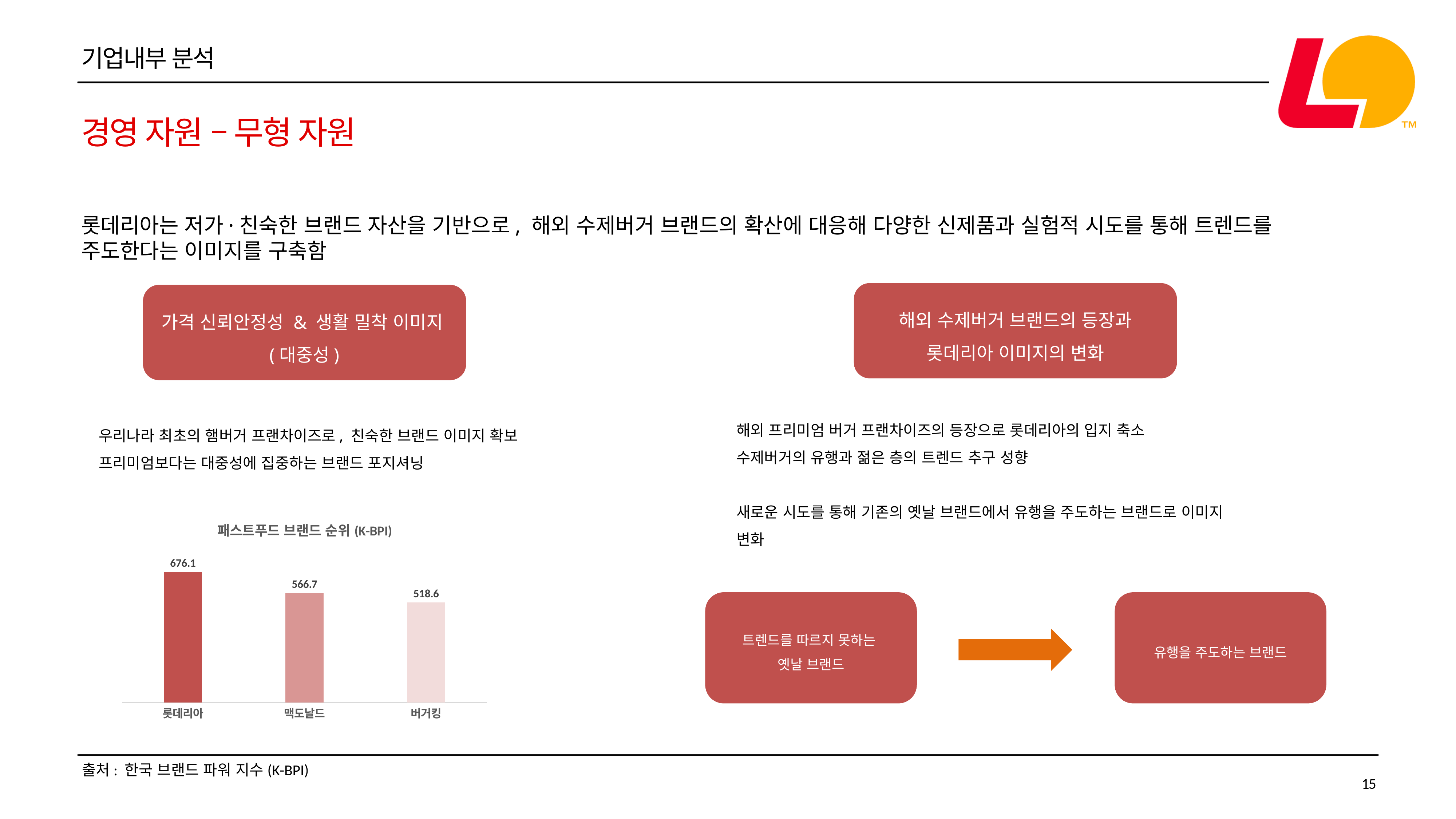
Which brand has the highest value in the chart? 롯데리아 What is the title of the chart on the slide? 패스트푸드 브랜드 순위 (K-BPI) What is the K-BPI value for 롯데리아 in the chart? 676.1 What is the K-BPI value for 맥도날드 in the chart? 566.7 What is the K-BPI value for 버거킹 in the chart? 518.6 How many brands are shown in the chart? 3 What kind of chart is shown on the slide? Bar chart Which has a larger value, 맥도날드 or 버거킹? 맥도날드 What is the difference between the values for 롯데리아 and 버거킹? 157.5 What is the difference between the values for 맥도날드 and 버거킹? 48.1 Which brand has the lowest value in the chart? 버거킹 What is the difference between the values for 롯데리아 and 맥도날드? 109.4